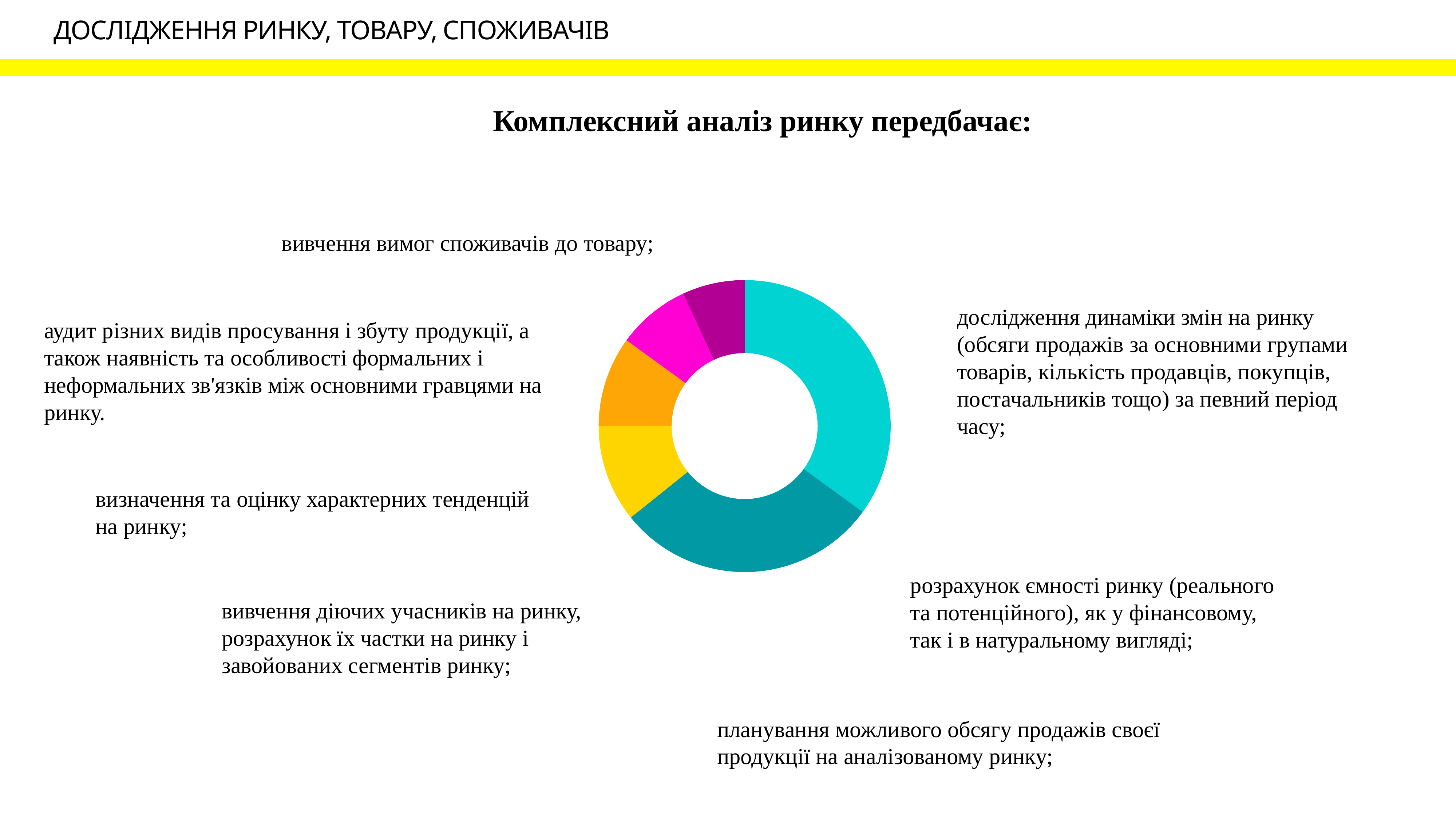
Does the doughnut chart have a legend? No What kind of chart is shown on the slide? Doughnut (pie) chart Which slice is larger, the magenta slice or the purple slice? Magenta Which colour slice is the smallest in the doughnut chart? Purple Which colour slice is the largest in the doughnut chart? Cyan (light blue) Does the doughnut chart display data labels with values on its slices? No How many slices does the doughnut chart have? 6 Which slice is larger, the cyan slice or the yellow slice? Cyan Which slice is larger, the teal (dark blue-green) slice or the orange slice? Teal